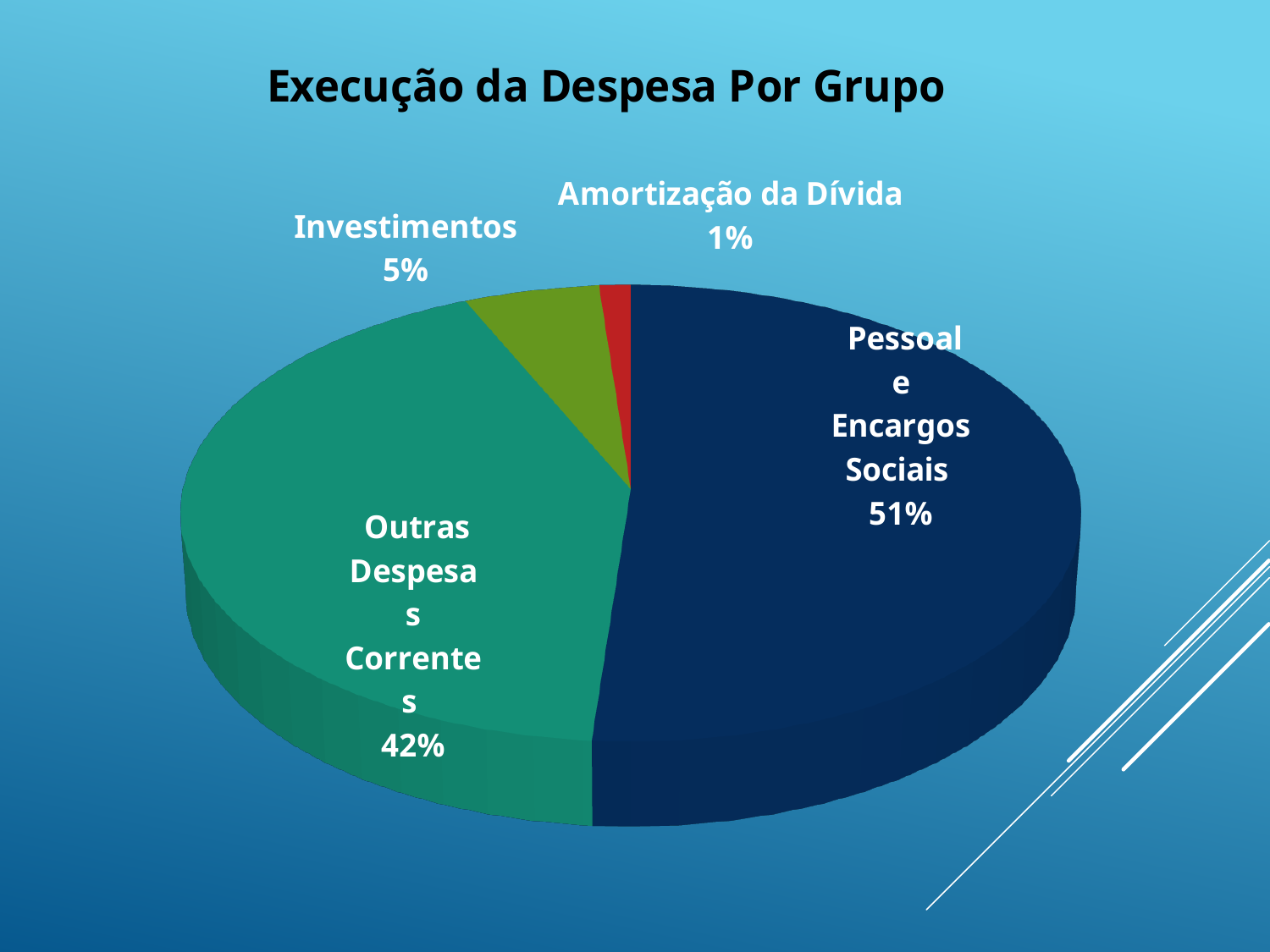
What colour is the slice for Outras Despesas Correntes? green Which category has the smallest slice of the pie? Amortização da Dívida What is the title of the chart? Execução da Despesa Por Grupo Which category has the largest slice of the pie? Pessoal e Encargos Sociais How many slices does the pie chart have? 4 What is the difference between the shares of Pessoal e Encargos Sociais and Outras Despesas Correntes? 9% Which is larger, the share for Investimentos or the share for Amortização da Dívida? Investimentos What kind of chart is shown on the slide? pie chart What share of the pie is Outras Despesas Correntes? 42% What is the value shown for Investimentos? 5% What is the value shown for Amortização da Dívida? 1% What share of the pie is Pessoal e Encargos Sociais? 51%